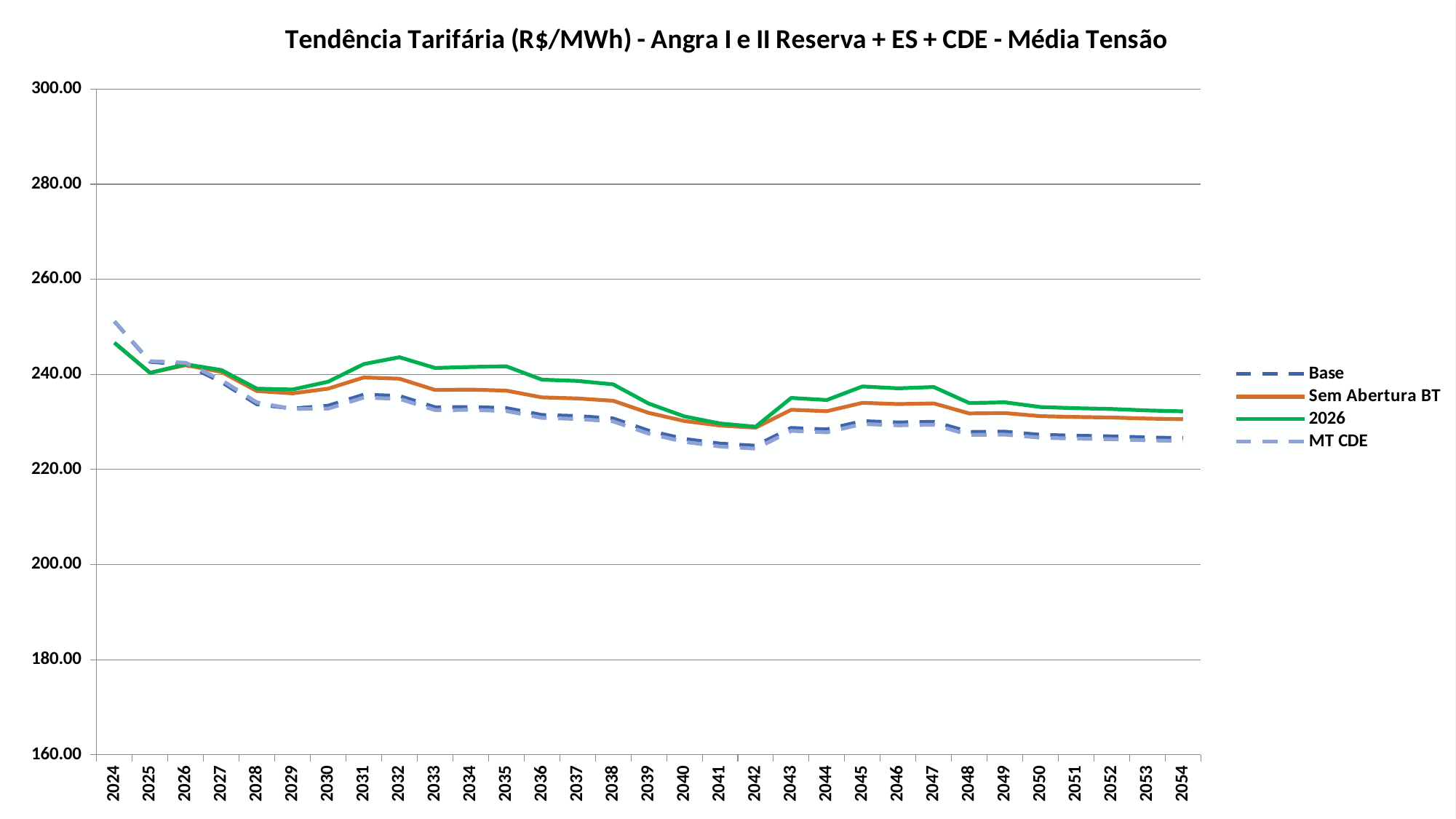
How many series does the legend list? 4 In which year does the 2026 series reach its highest value? 2024 Is the value for the 2026 series in 2032 greater or less than 240? greater In 2054, which is higher: the 2026 series or Base? 2026 In 2024, which is higher: MT CDE or the 2026 series? MT CDE What kind of chart is shown on the slide? Line chart What is the title of the chart? Tendência Tarifária (R$/MWh) - Angra I e II Reserva + ES + CDE - Média Tensão Is the value for MT CDE in 2024 greater or less than 240? greater Is the value for Base in 2042 greater or less than 240? less How many years are shown along the x axis? 31 Overall, does the Base series rise or fall from 2024 to 2054? Fall